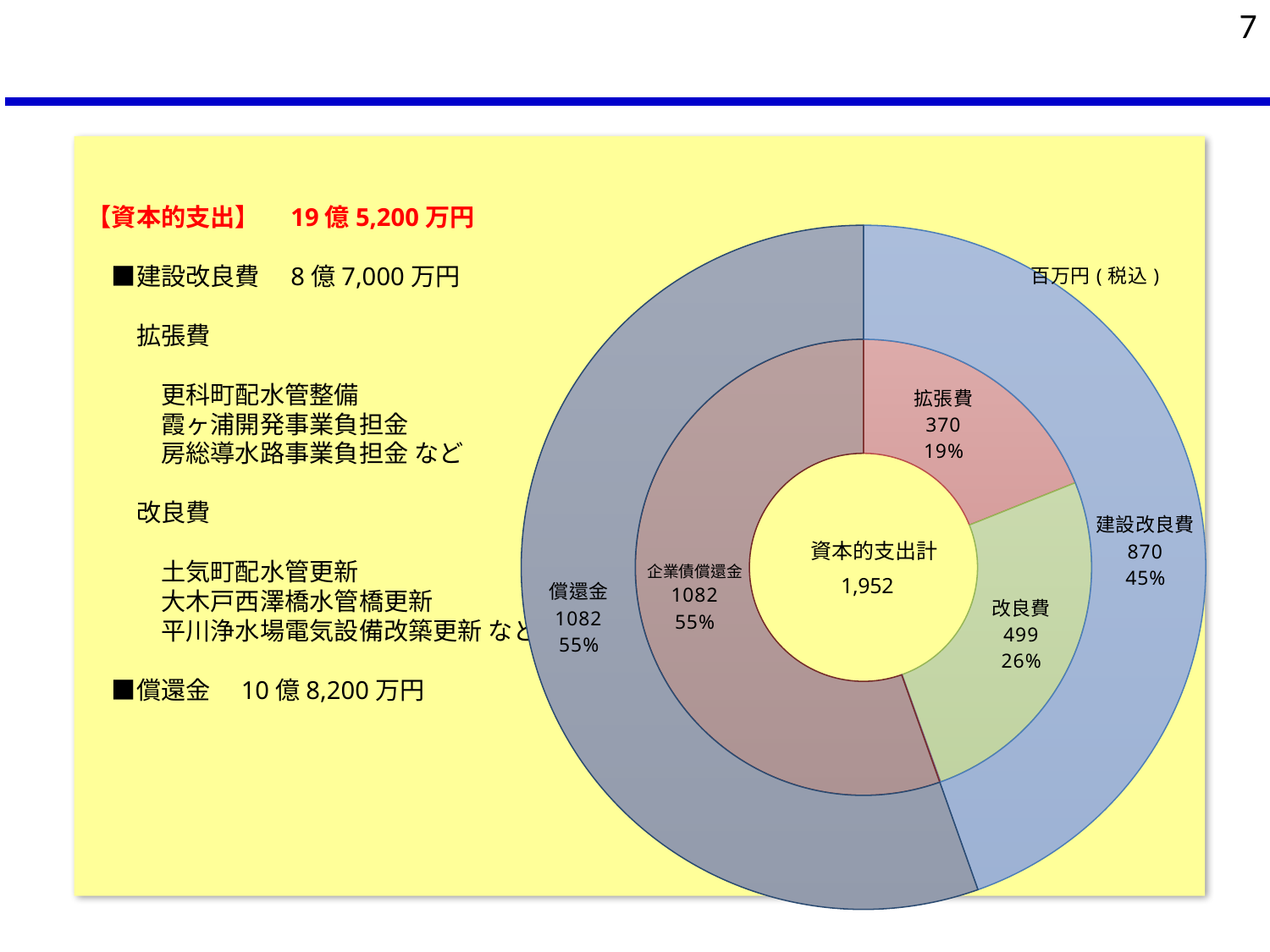
What is the difference between the values for 改良費 and 拡張費? 129 What is the value shown for 拡張費 in the inner ring? 370 Which segment of the inner ring has the smallest value? 拡張費 What total is shown in the centre of the chart for 資本的支出計? 1,952 Which segment of the inner ring has the largest value? 企業債償還金 What is the value shown for 改良費 in the inner ring? 499 What percentage share is shown for 改良費? 26% What kind of chart is shown on the slide? doughnut chart What unit is stated for the values in the chart? 百万円(税込) What is the value shown for 建設改良費 in the outer ring? 870 What is the value shown for 償還金 in the outer ring? 1082 What percentage share is shown for 償還金 in the outer ring? 55%